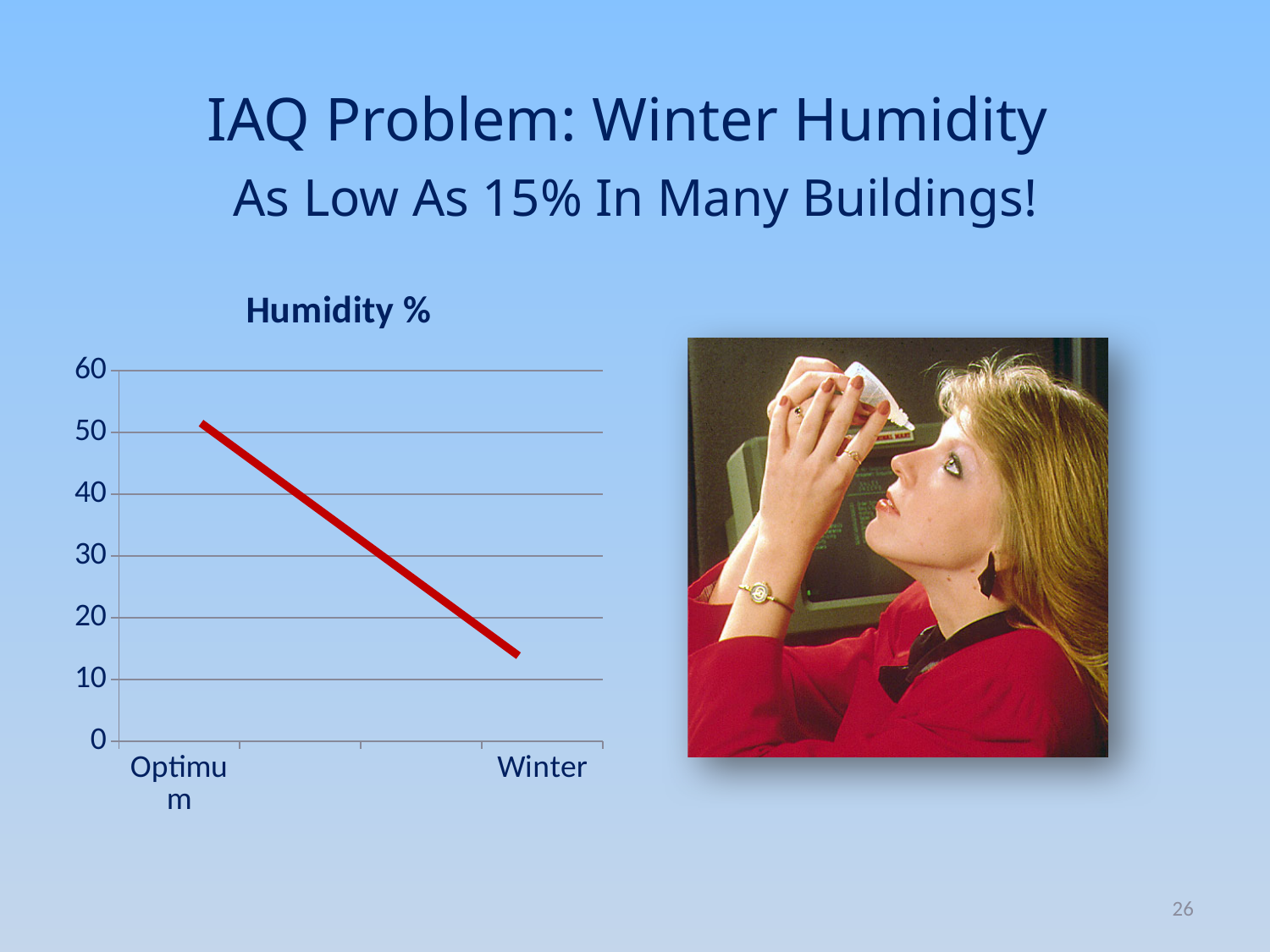
Which category has the highest humidity value? Optimum Is the value for Winter greater or less than 10? greater Does the humidity value rise or fall from Optimum to Winter? fall How many categories are plotted on the x axis of the chart? 2 Is the value for Winter greater or less than 20? less Is the value for Optimum greater or less than 40? greater What is the title of the chart? Humidity % What colour is the line in the chart? red What kind of chart is shown on the slide? line chart Which category has the lowest humidity value? Winter Which category has the higher humidity value, Optimum or Winter? Optimum